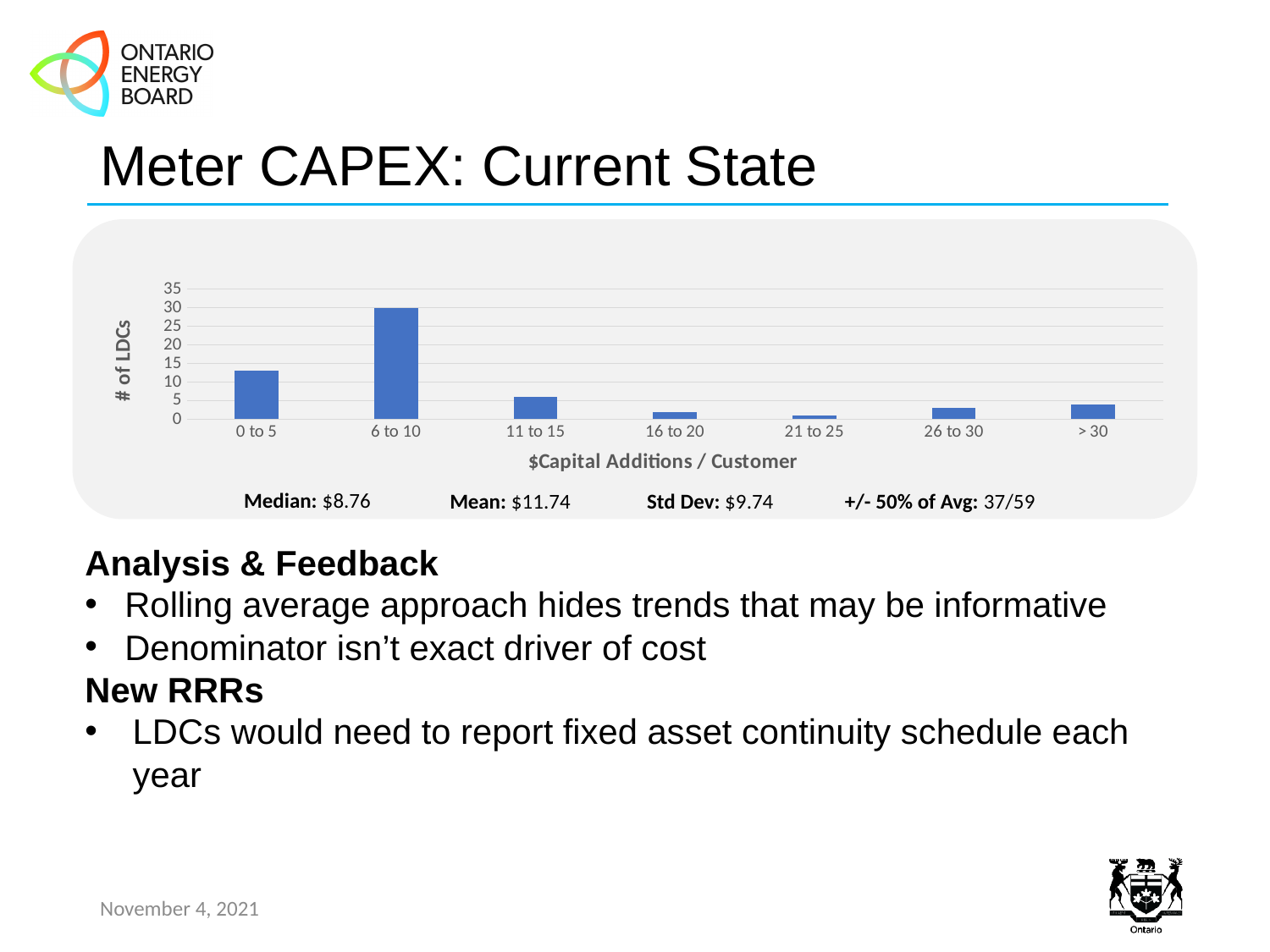
Which has more LDCs, the 0 to 5 category or the 11 to 15 category? 0 to 5 Which category has the highest number of LDCs? 6 to 10 What is the title of the y axis of the chart? # of LDCs What is the number of LDCs for the 6 to 10 category? 30 What is the title of the x axis of the chart? $Capital Additions / Customer Is the value for 26 to 30 greater or less than 5? less Is the value for 0 to 5 greater or less than 10? greater How many categories are shown on the x axis of the chart? 7 What kind of chart is shown on the slide? bar chart Which category has the lowest number of LDCs? 21 to 25 Is the value for 16 to 20 greater or less than 5? less